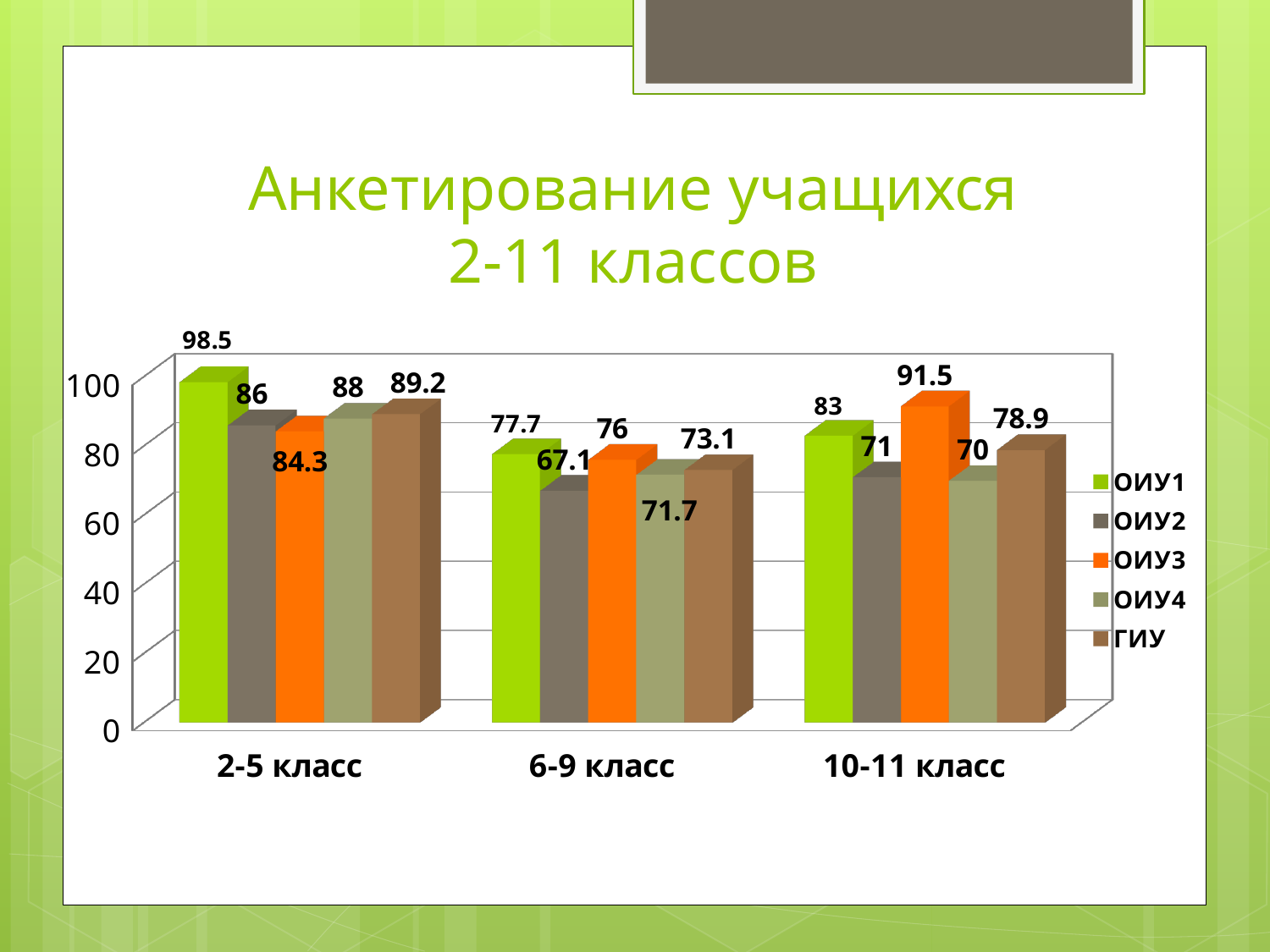
What is the difference between the ОИУ1 and ОИУ2 values in the 2-5 класс category? 12.5 Which series has the highest value in the 6-9 класс category? ОИУ1 What is the value for ОИУ3 in the 10-11 класс category? 91.5 What is the value for ГИУ in the 6-9 класс category? 73.1 What is the title of the slide? Анкетирование учащихся 2-11 классов Which is larger: the ОИУ3 value for 2-5 класс or the ОИУ3 value for 10-11 класс? 10-11 класс Which series has the lowest value in the 10-11 класс category? ОИУ4 What is the value for ОИУ1 in the 2-5 класс category? 98.5 How many categories are shown on the x axis? 3 What kind of chart is shown on the slide? bar chart Is the value for ОИУ2 in the 6-9 класс category greater or less than 80? less How many series does the legend list? 5